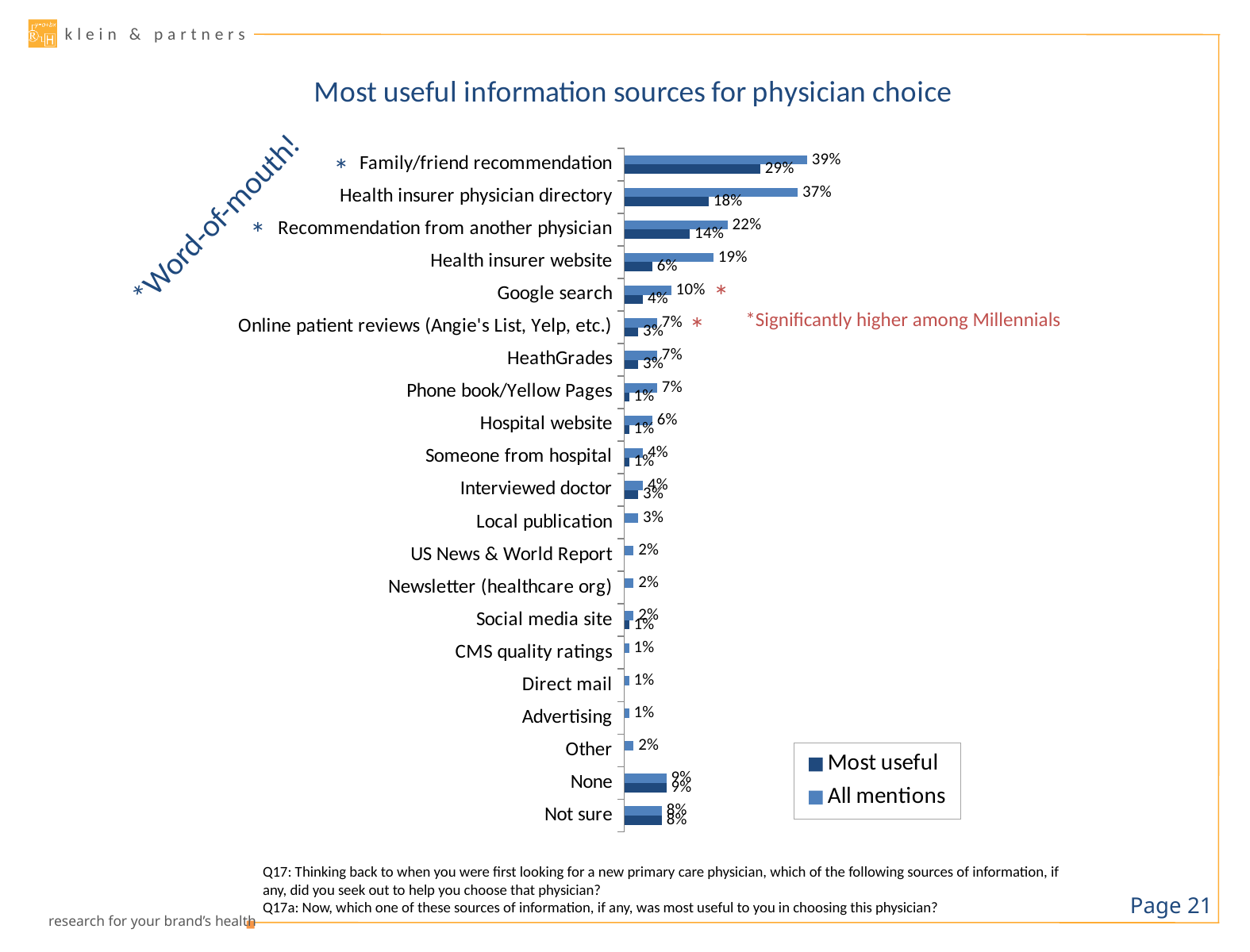
What kind of chart is shown on the slide? Bar chart Which is larger: the 'Most useful' value for Family/friend recommendation or the 'Most useful' value for Health insurer physician directory? Family/friend recommendation What is the 'All mentions' value for Google search? 10% What is the title of the chart? Most useful information sources for physician choice What is the 'Most useful' value for Recommendation from another physician? 14% What is the 'All mentions' value for Family/friend recommendation? 39% What is the difference between the 'All mentions' and 'Most useful' values for Health insurer website? 13% How many information source categories are shown on the chart? 21 Which information source has the highest 'All mentions' value? Family/friend recommendation How many series does the legend list? 2 What is the difference between the 'All mentions' values for Family/friend recommendation and Health insurer physician directory? 2% What is the 'Most useful' value for Health insurer physician directory? 18%